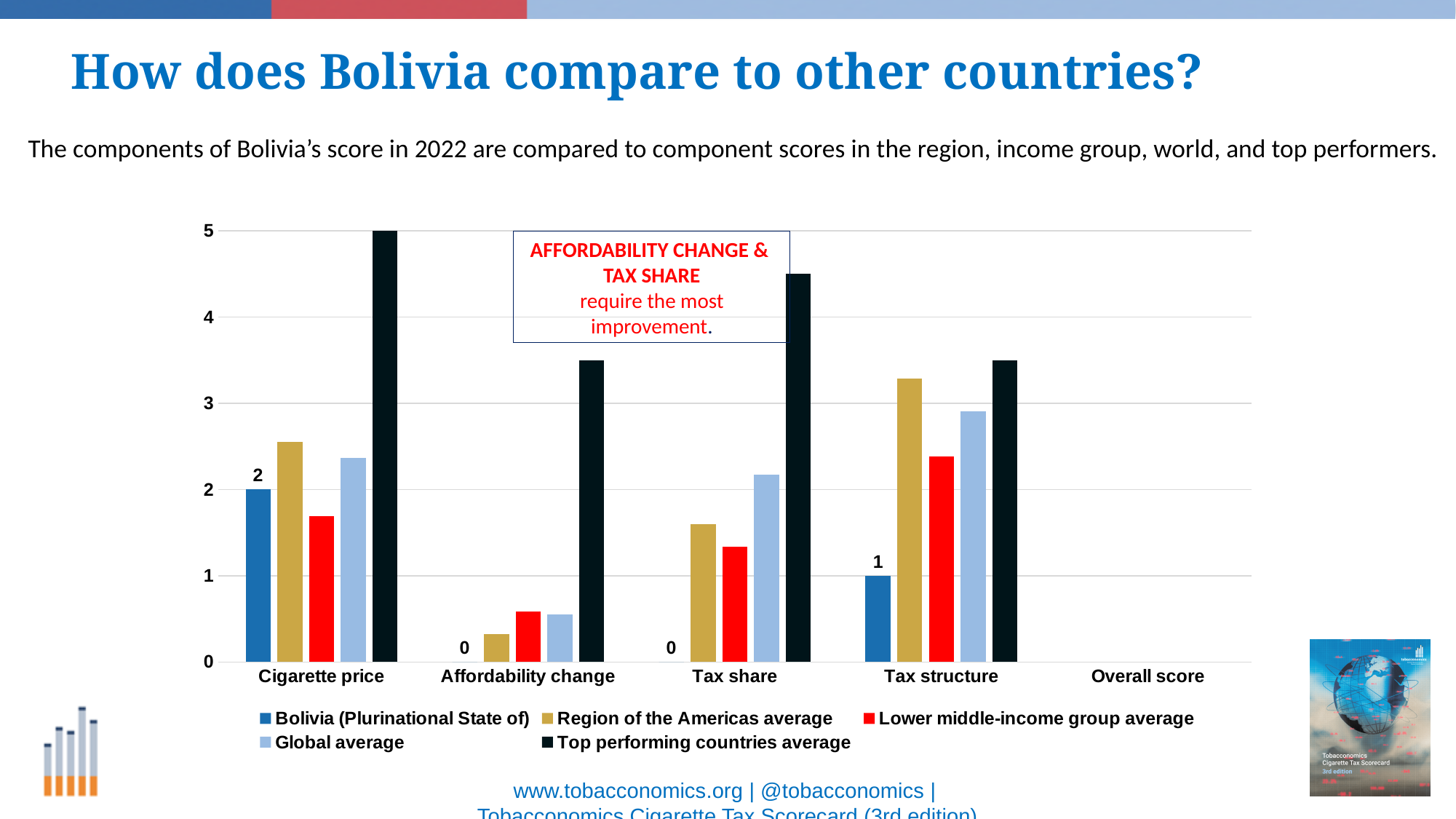
Is the value for Region of the Americas average for Tax structure greater or less than 3? greater Which is larger for Bolivia (Plurinational State of): Cigarette price or Tax structure? Cigarette price Is the value for Lower middle-income group average for Tax share greater or less than 2? less What is the value for Top performing countries average for Cigarette price? 5 What is the value for Bolivia (Plurinational State of) for Tax structure? 1 What kind of chart is shown on the slide? bar chart How many categories are shown on the x axis of the chart? 5 Which series has the highest value for Cigarette price? Top performing countries average How many series does the legend list? 5 What is the difference between Bolivia's Cigarette price score and its Tax structure score? 1 What is the value for Bolivia (Plurinational State of) for Cigarette price? 2 What is the value for Bolivia (Plurinational State of) for Affordability change? 0